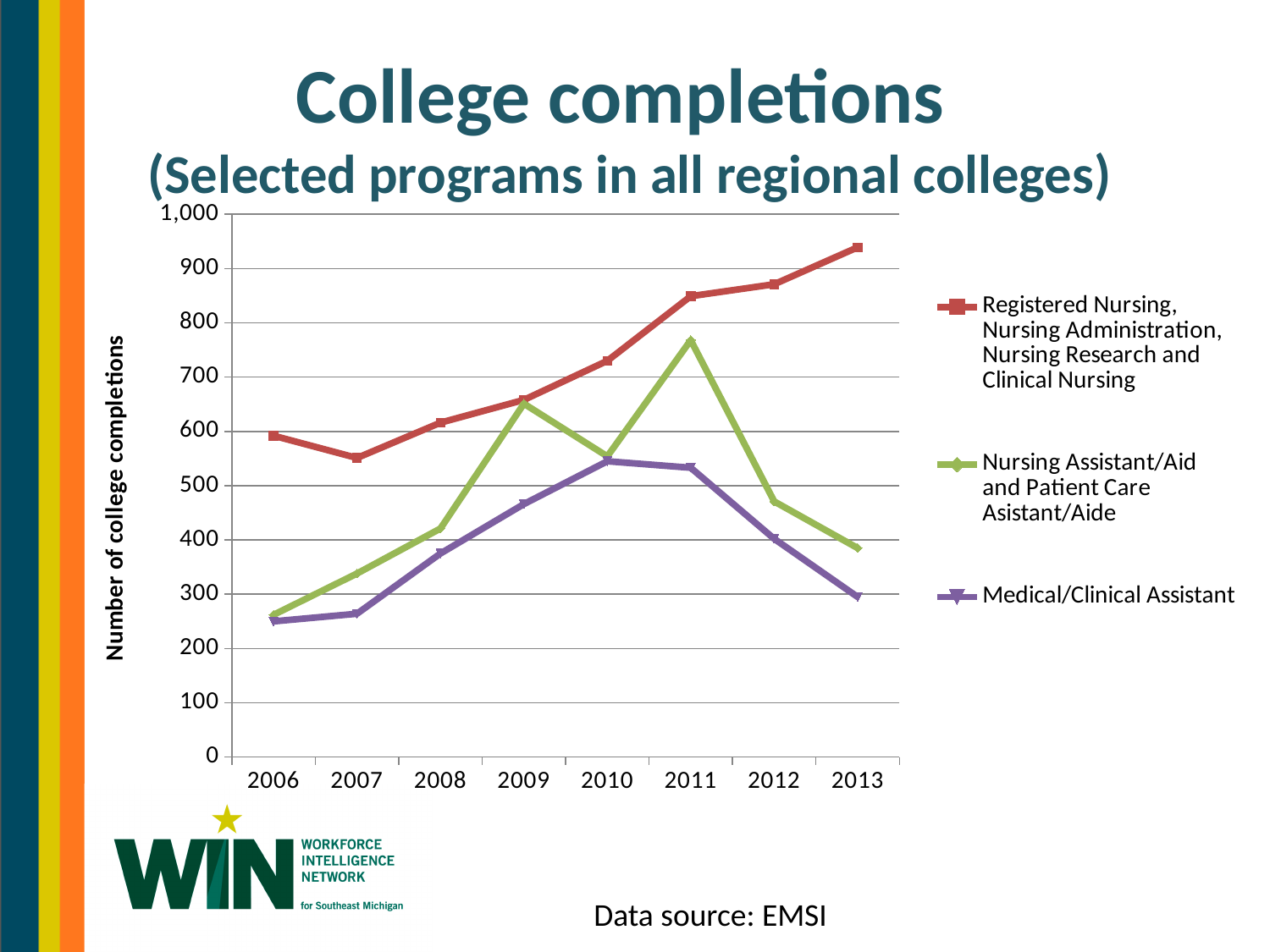
In which year is the value for Registered Nursing, Nursing Administration, Nursing Research and Clinical Nursing lowest? 2007 What kind of chart is shown on the slide? Line chart How many series does the legend list? 3 In which year is the value for Registered Nursing, Nursing Administration, Nursing Research and Clinical Nursing highest? 2013 In 2010, which is larger: the value for Registered Nursing, Nursing Administration, Nursing Research and Clinical Nursing or the value for Nursing Assistant/Aid and Patient Care Asistant/Aide? Registered Nursing, Nursing Administration, Nursing Research and Clinical Nursing Is the value for Medical/Clinical Assistant in 2006 greater or less than 300? less What is the title of the vertical axis? Number of college completions Does the value for Registered Nursing, Nursing Administration, Nursing Research and Clinical Nursing rise or fall from 2007 to 2013? Rise How many years are shown on the x axis? 8 Is the value for Registered Nursing, Nursing Administration, Nursing Research and Clinical Nursing in 2013 greater or less than 900? greater Is the value for Nursing Assistant/Aid and Patient Care Asistant/Aide in 2011 greater or less than 700? greater In which year is the value for Nursing Assistant/Aid and Patient Care Asistant/Aide highest? 2011